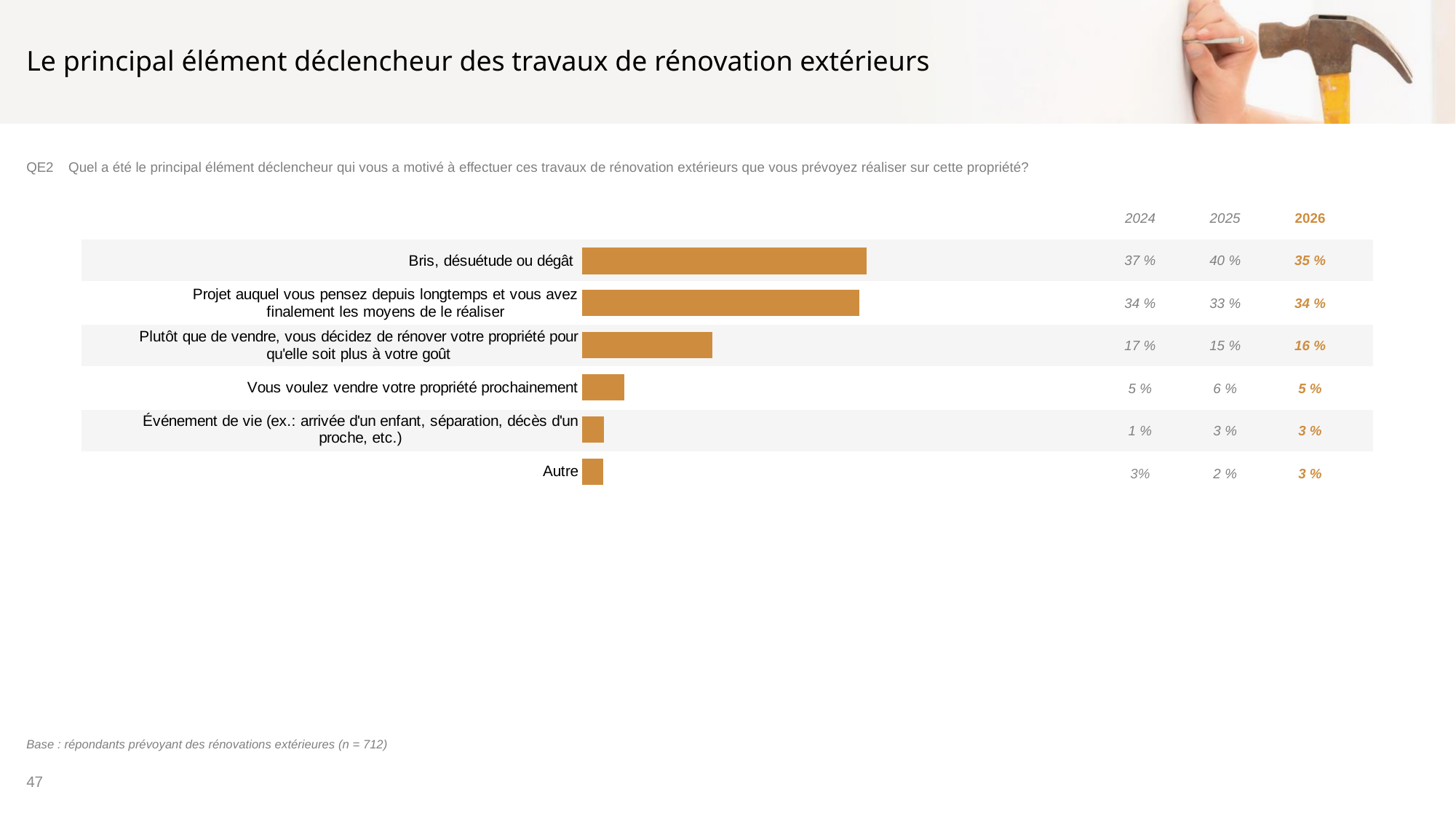
What kind of chart is shown on the slide? bar chart What is the 2024 value for "Plutôt que de vendre, vous décidez de rénover votre propriété pour qu'elle soit plus à votre goût"? 17 % Which years are listed as columns next to the bar chart? 2024, 2025, 2026 What is the 2026 value for "Bris, désuétude ou dégât"? 35 % How did the value for "Événement de vie (ex.: arrivée d'un enfant, séparation, décès d'un proche, etc.)" change from 2024 to 2026? It rose from 1 % to 3 % How many categories does the bar chart show? 6 What is the difference between the 2026 values for "Bris, désuétude ou dégât" and "Plutôt que de vendre, vous décidez de rénover votre propriété pour qu'elle soit plus à votre goût"? 19 % Which category has the highest 2026 value? Bris, désuétude ou dégât What is the 2025 value for "Vous voulez vendre votre propriété prochainement"? 6 % Which is larger for "Bris, désuétude ou dégât": the 2025 value or the 2026 value? 2025 What is the base (n) stated at the bottom of the slide? n = 712 Which category has the lowest 2025 value? Autre